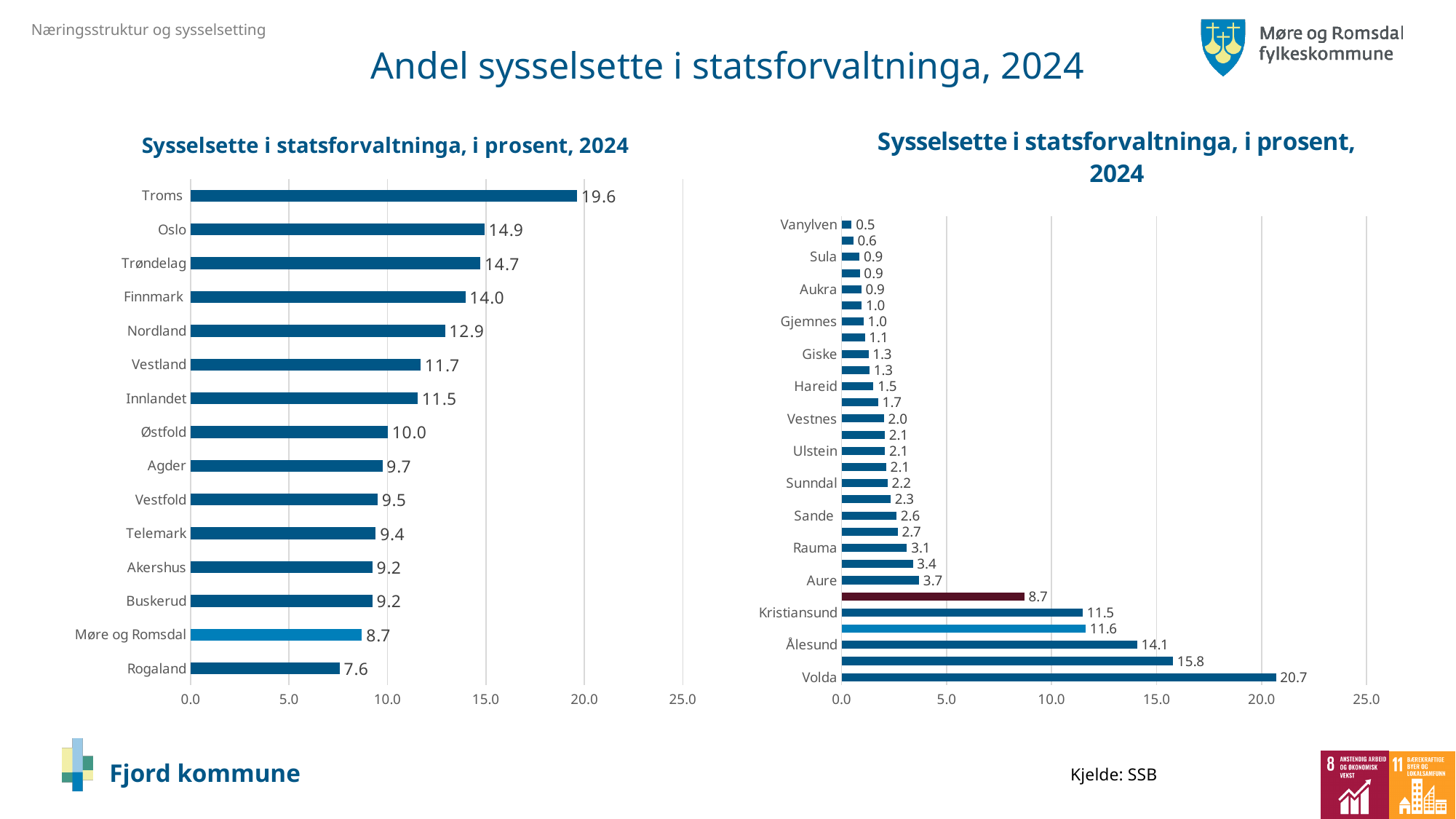
On the left chart, which is larger, Vestland or Innlandet? Vestland On the right chart, what is the value for Kristiansund? 11.5 On the left chart, what is the value for Troms? 19.6 On the left chart, what is the difference between Oslo and Trøndelag? 0.2 On the left chart, what is the value for Møre og Romsdal? 8.7 On the left chart, which bar is shown in a lighter blue colour than the others? Møre og Romsdal On the right chart, what is the value for Volda? 20.7 How many counties are shown on the left chart? 15 On the right chart, what is the difference between Ålesund and Aure? 10.4 What kind of chart is the left chart? Bar chart On the left chart, which county has the lowest value? Rogaland On the right chart, which municipality has the highest value? Volda